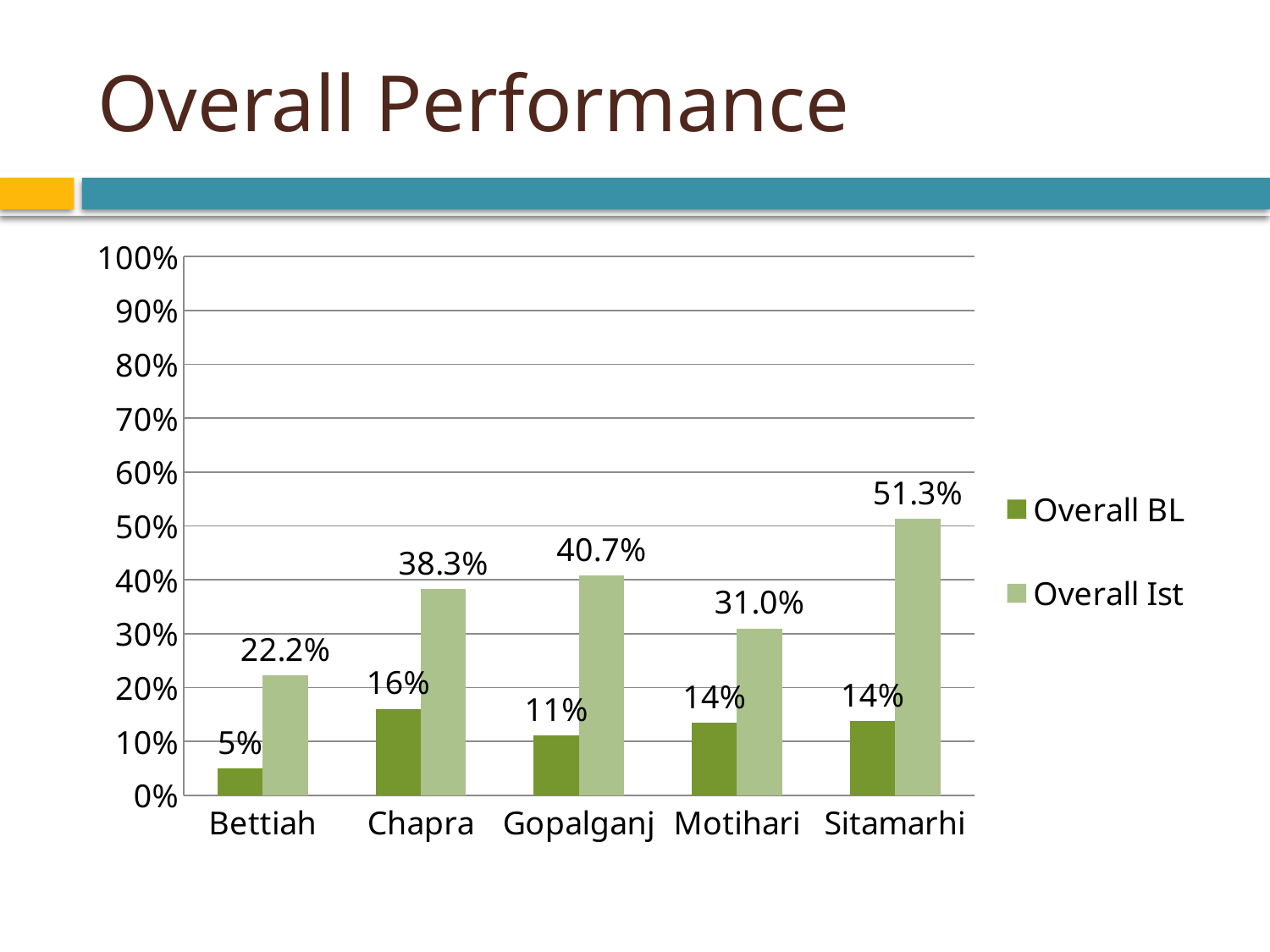
What is the Overall Ist value for Motihari? 31.0% What is the title of the slide? Overall Performance What is the Overall BL value for Bettiah? 5% What is the Overall Ist value for Sitamarhi? 51.3% How many categories are shown on the x axis? 5 Which category has the lowest Overall BL value? Bettiah Which is larger: the Overall Ist value for Chapra or for Motihari? Chapra How many series does the legend list? 2 What kind of chart is shown on the slide? bar chart Is the Overall Ist value for Sitamarhi greater or less than 50%? greater Which category has the highest Overall Ist value? Sitamarhi What is the difference between the Overall Ist values for Gopalganj and Chapra? 2.4%